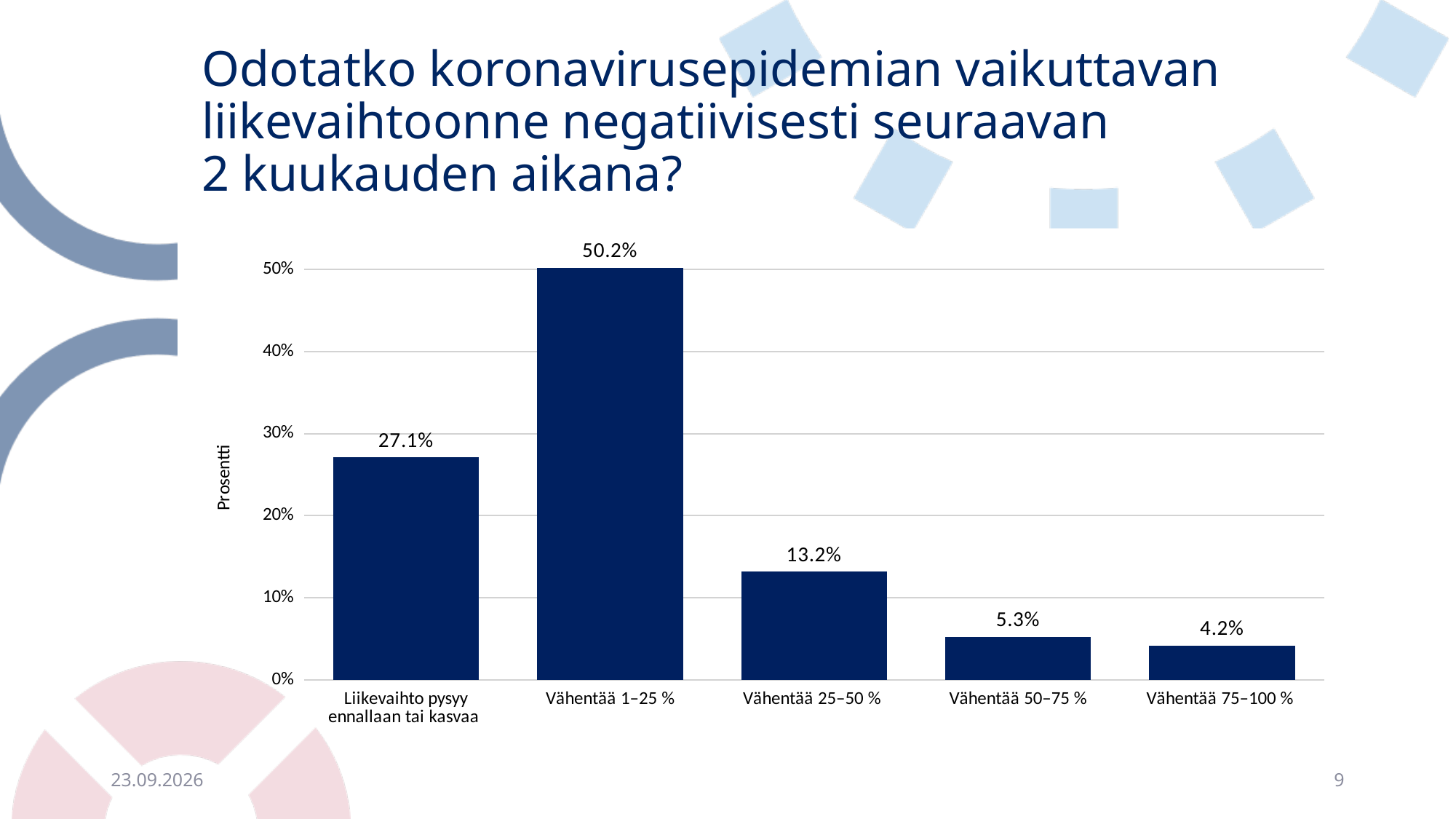
Which is larger, the value for "Vähentää 50–75 %" or "Vähentää 75–100 %"? Vähentää 50–75 % What is the value for "Liikevaihto pysyy ennallaan tai kasvaa"? 27.1% What is the difference between the values for "Vähentää 1–25 %" and "Vähentää 25–50 %"? 37.0% How many categories are shown on the x axis? 5 What is the value for "Vähentää 1–25 %"? 50.2% What is the label of the vertical axis? Prosentti What is the difference between the values for "Vähentää 50–75 %" and "Vähentää 75–100 %"? 1.1% What is the value for "Vähentää 75–100 %"? 4.2% Which category has the lowest value? Vähentää 75–100 % What kind of chart is shown on the slide? bar chart Is the value for "Vähentää 25–50 %" greater or less than 10%? greater Which category has the highest value? Vähentää 1–25 %